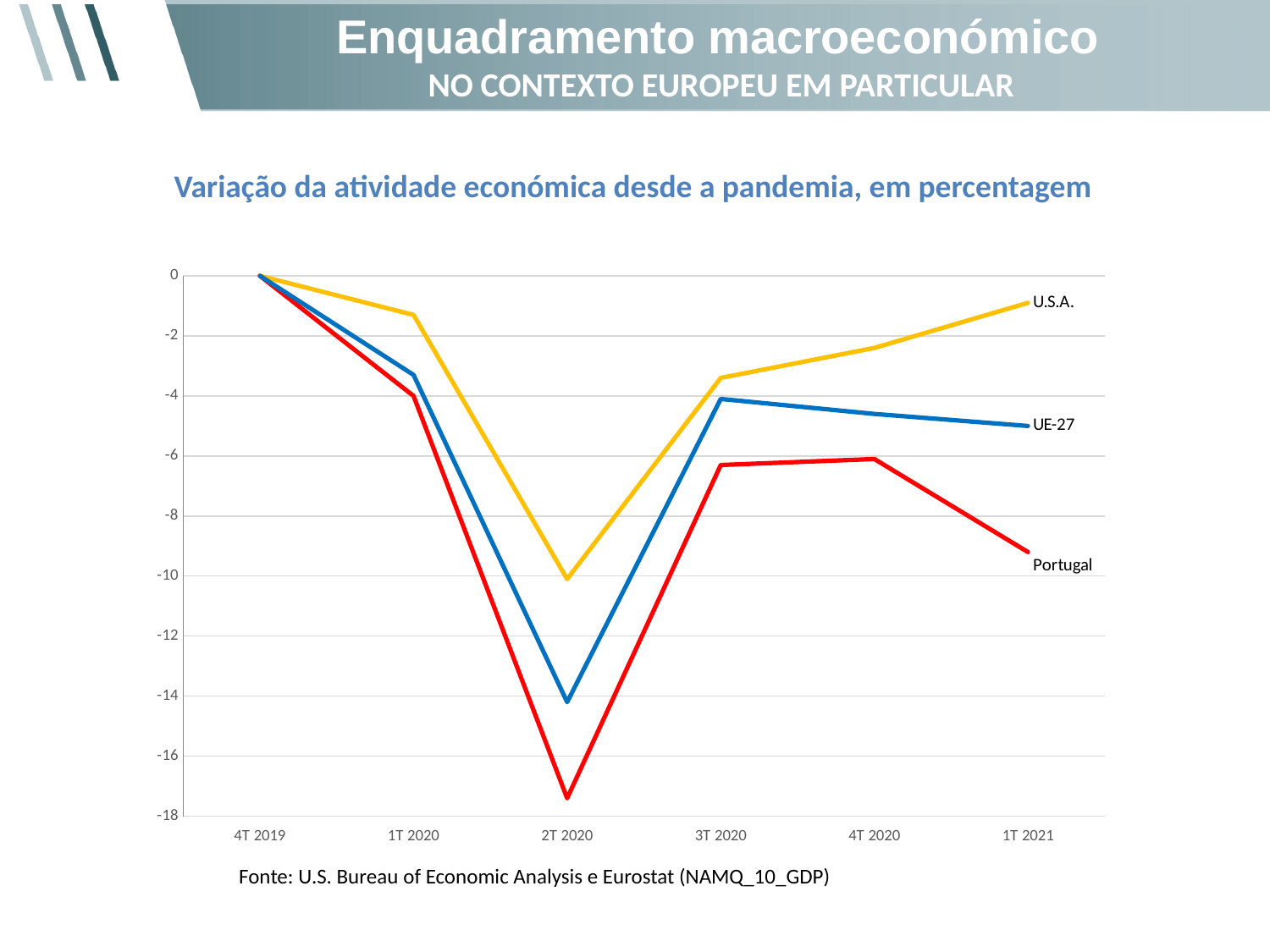
Is the value for U.S.A. in 1T 2020 greater or less than -2? greater Is the value for Portugal in 1T 2021 greater or less than -8? less What is the value for Portugal in 4T 2019? 0 How many quarters are shown along the x axis? 6 How many series are plotted in the chart? 3 Does the Portugal line rise or fall between 4T 2020 and 1T 2021? fall What kind of chart is shown on the slide? line chart Is the value for Portugal in 2T 2020 greater or less than -16? less Which series has the lowest value in 2T 2020? Portugal In which quarter does the Portugal line reach its lowest value? 2T 2020 In 1T 2021, which is higher: U.S.A. or Portugal? U.S.A.